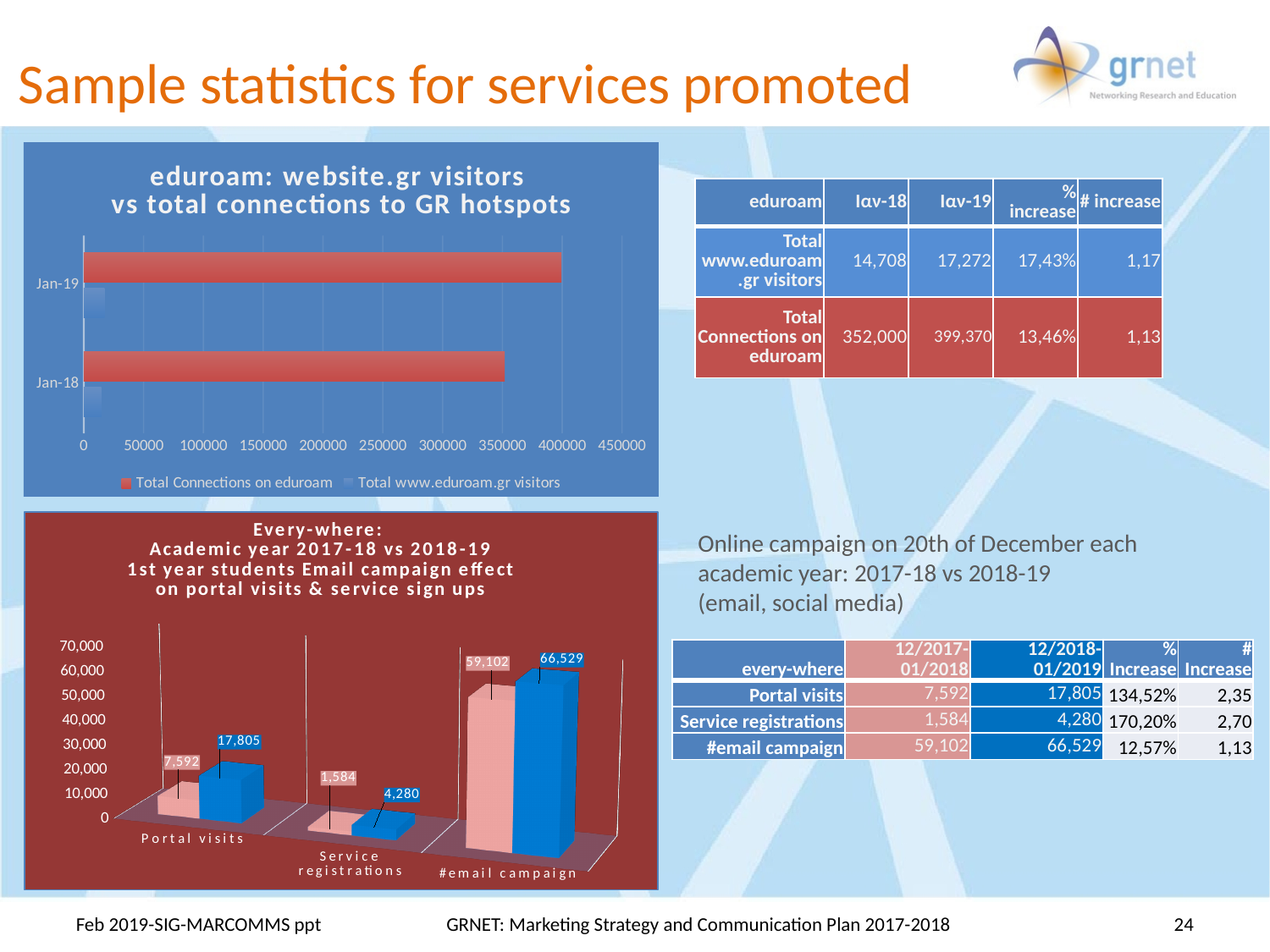
In the bottom-left chart 'Every-where: Academic year 2017-18 vs 2018-19', which category has the highest values? #email campaign In the top-left chart 'eduroam: website.gr visitors vs total connections to GR hotspots', how many series does the legend list? 2 In the top-left chart 'eduroam: website.gr visitors vs total connections to GR hotspots', is the value for Total Connections on eduroam in Jan-19 greater or less than 350000? greater In the top-left chart 'eduroam: website.gr visitors vs total connections to GR hotspots', which year has the larger Total Connections on eduroam bar, Jan-18 or Jan-19? Jan-19 In the bottom-left chart 'Every-where: Academic year 2017-18 vs 2018-19', what is the value of the blue (second) bar for Portal visits? 17,805 In the top-left chart 'eduroam: website.gr visitors vs total connections to GR hotspots', what kind of chart is shown? Bar chart In the top-left chart 'eduroam: website.gr visitors vs total connections to GR hotspots', is the value for Total Connections on eduroam in Jan-18 greater or less than 400000? less In the bottom-left chart 'Every-where: Academic year 2017-18 vs 2018-19', how many categories are shown on the x axis? 3 In the top-left chart 'eduroam: website.gr visitors vs total connections to GR hotspots', what is the highest value shown on the horizontal axis? 450000 In the bottom-left chart 'Every-where: Academic year 2017-18 vs 2018-19', what is the difference between the blue and pink bars for #email campaign? 7,427 In the bottom-left chart 'Every-where: Academic year 2017-18 vs 2018-19', what is the value of the pink (first) bar for Service registrations? 1,584 In the bottom-left chart 'Every-where: Academic year 2017-18 vs 2018-19', which category has the lowest values? Service registrations